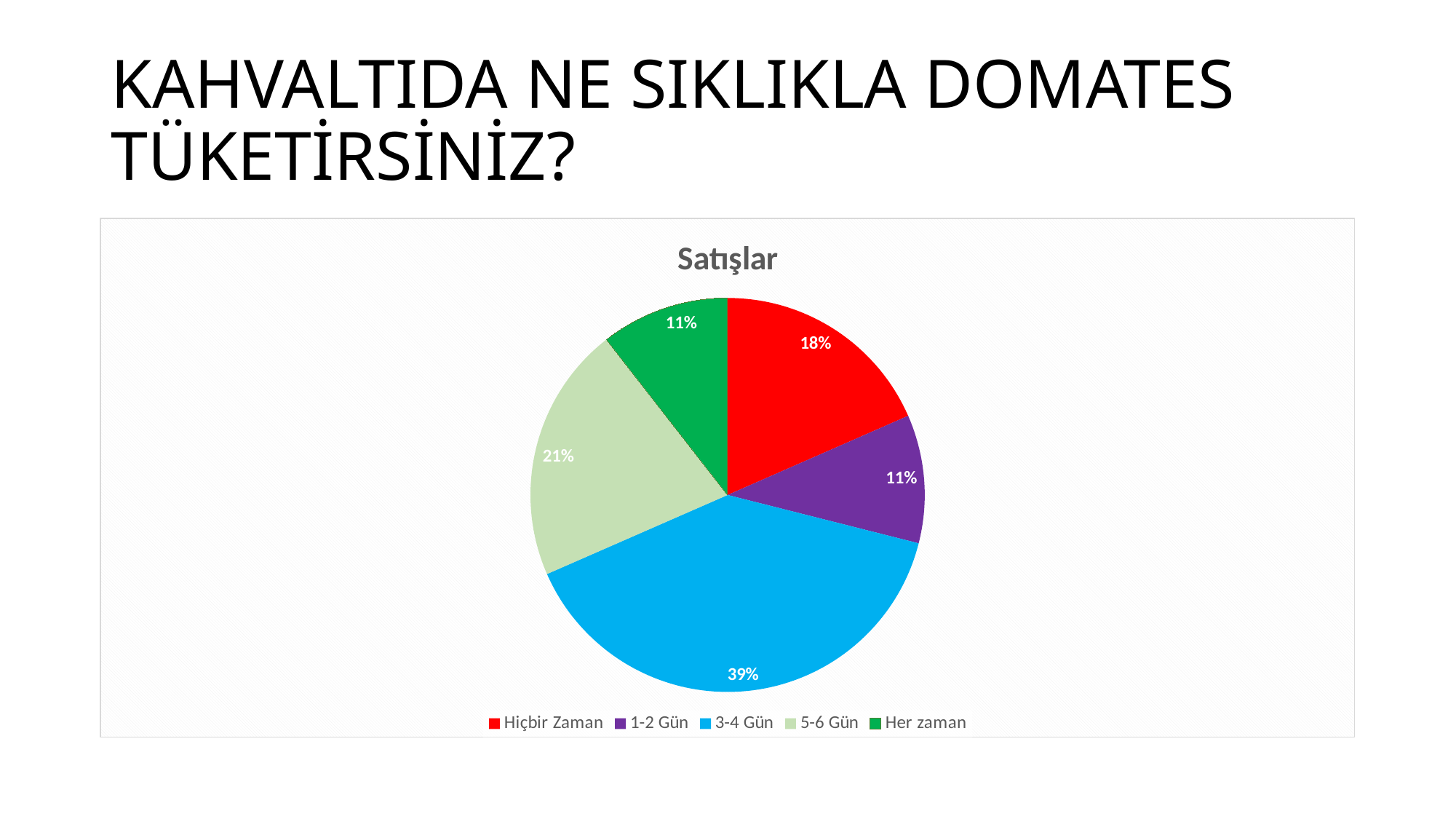
How many categories does the legend list? 5 What is the difference between the Hiçbir Zaman share and the Her zaman share? 7% What is the chart's title? Satışlar What colour is the 3-4 Gün slice? blue What share of the pie does the Hiçbir Zaman slice represent? 18% What kind of chart is shown on the slide? pie chart What is the difference between the 3-4 Gün share and the 5-6 Gün share? 18% Which is larger, the Hiçbir Zaman slice or the 1-2 Gün slice? Hiçbir Zaman What share of the pie does the Her zaman slice represent? 11% What share of the pie does the 3-4 Gün slice represent? 39% Which category has the largest slice of the pie? 3-4 Gün